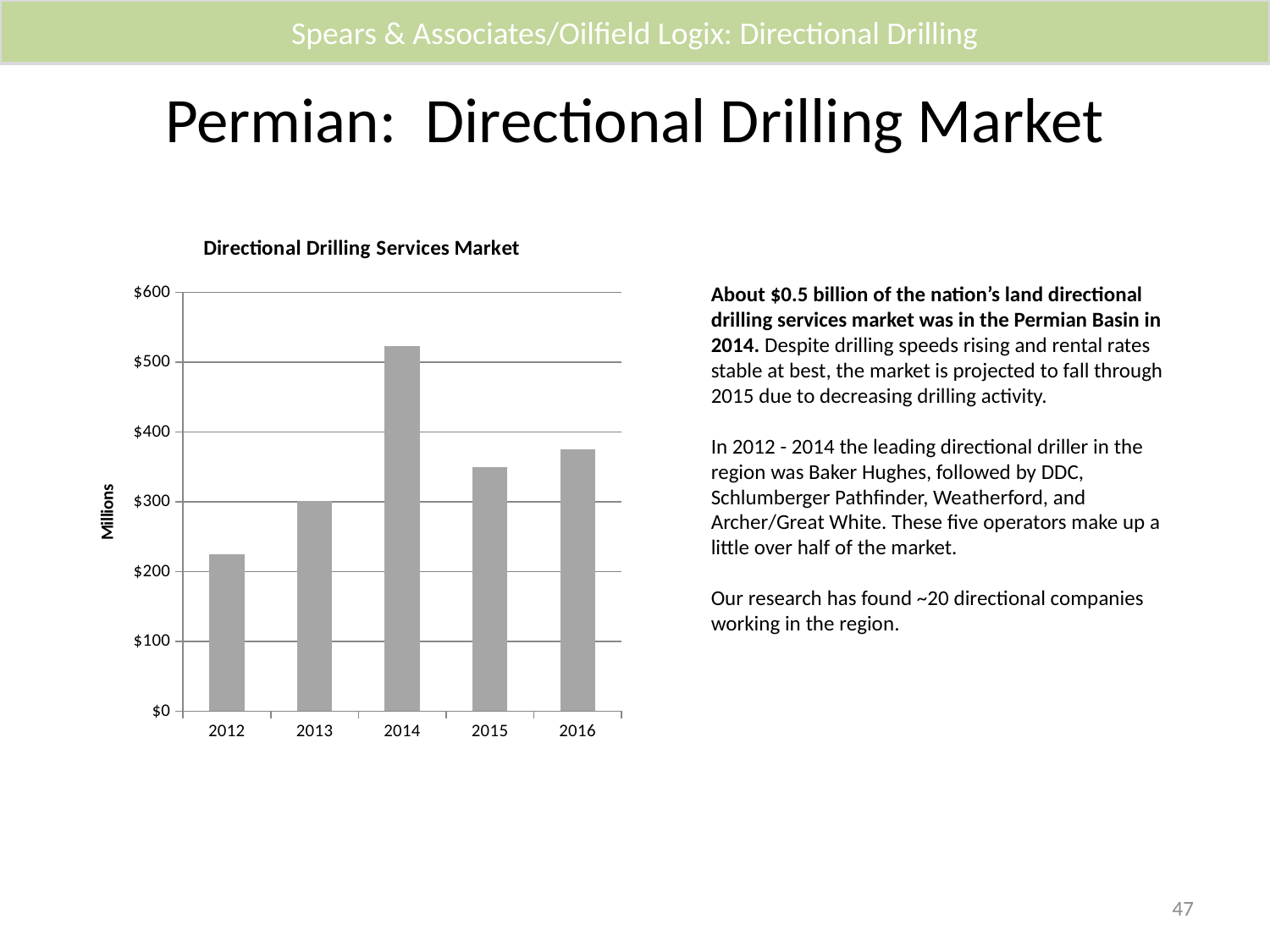
Which year has the highest value in the chart? 2014 Is the value for 2016 greater or less than $300? greater What type of chart is shown on the slide? bar chart Is the value for 2015 greater or less than $400? less How many years are shown on the x axis of the chart? 5 Is the value for 2014 greater or less than $500? greater Which is larger, the value for 2014 or the value for 2015? 2014 What is the label on the vertical axis of the chart? Millions Which year has the lowest value in the chart? 2012 Do the values rise or fall from 2012 to 2014? rise What is the title of the chart? Directional Drilling Services Market